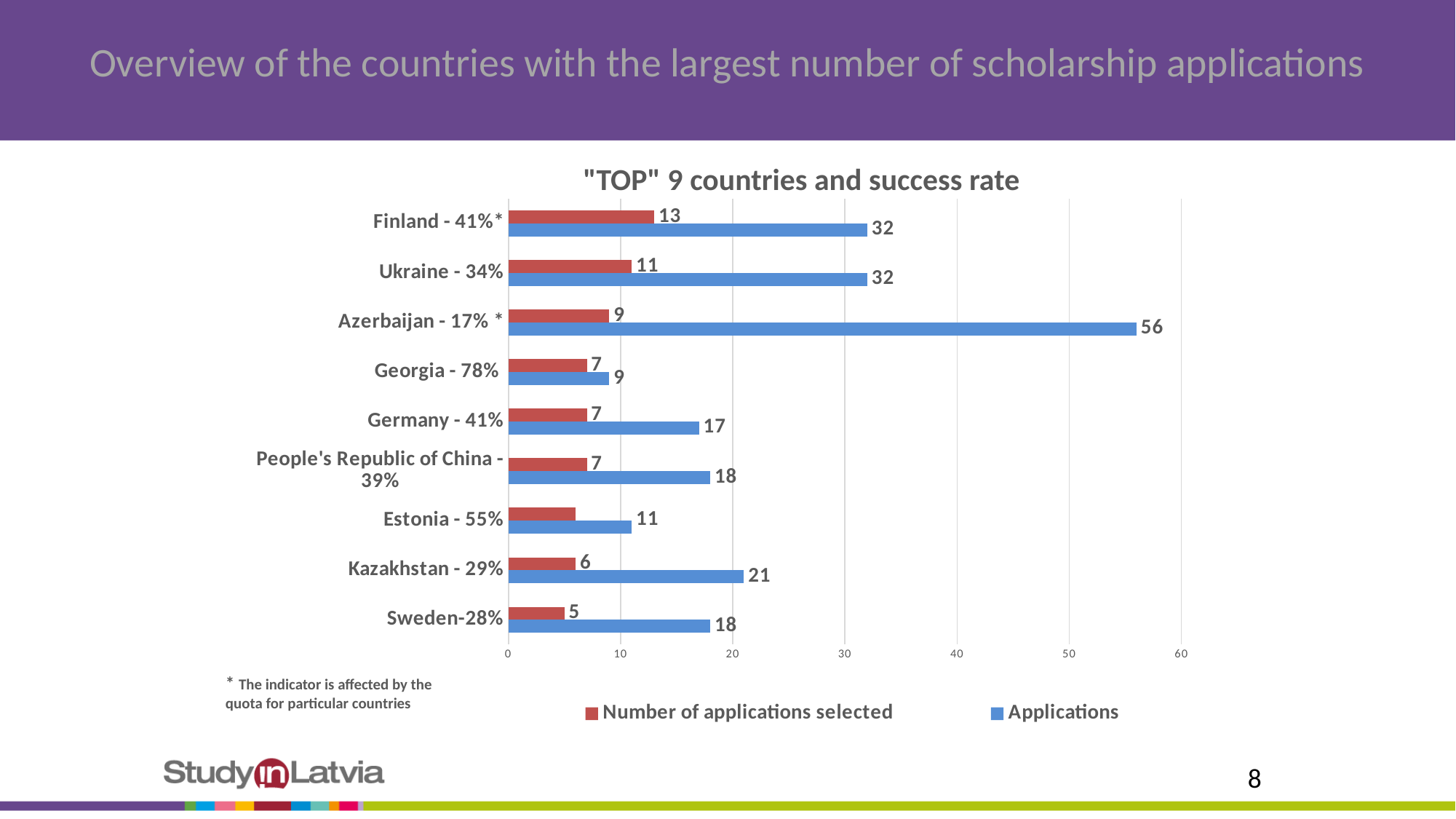
Which country has the highest number of applications? Azerbaijan What is the difference between the number of applications and the number of applications selected for Azerbaijan? 47 How many applications did Ukraine have? 32 Is the number of applications selected for Estonia greater or less than 10? less Which has more applications, Kazakhstan or Sweden? Kazakhstan Which country has the lowest number of applications? Georgia How many applications did Azerbaijan have? 56 What is the number of applications selected for Finland? 13 What type of chart is shown on the slide? bar chart Which country has the highest number of applications selected? Finland How many series does the legend list? 2 How many countries are shown in the chart? 9